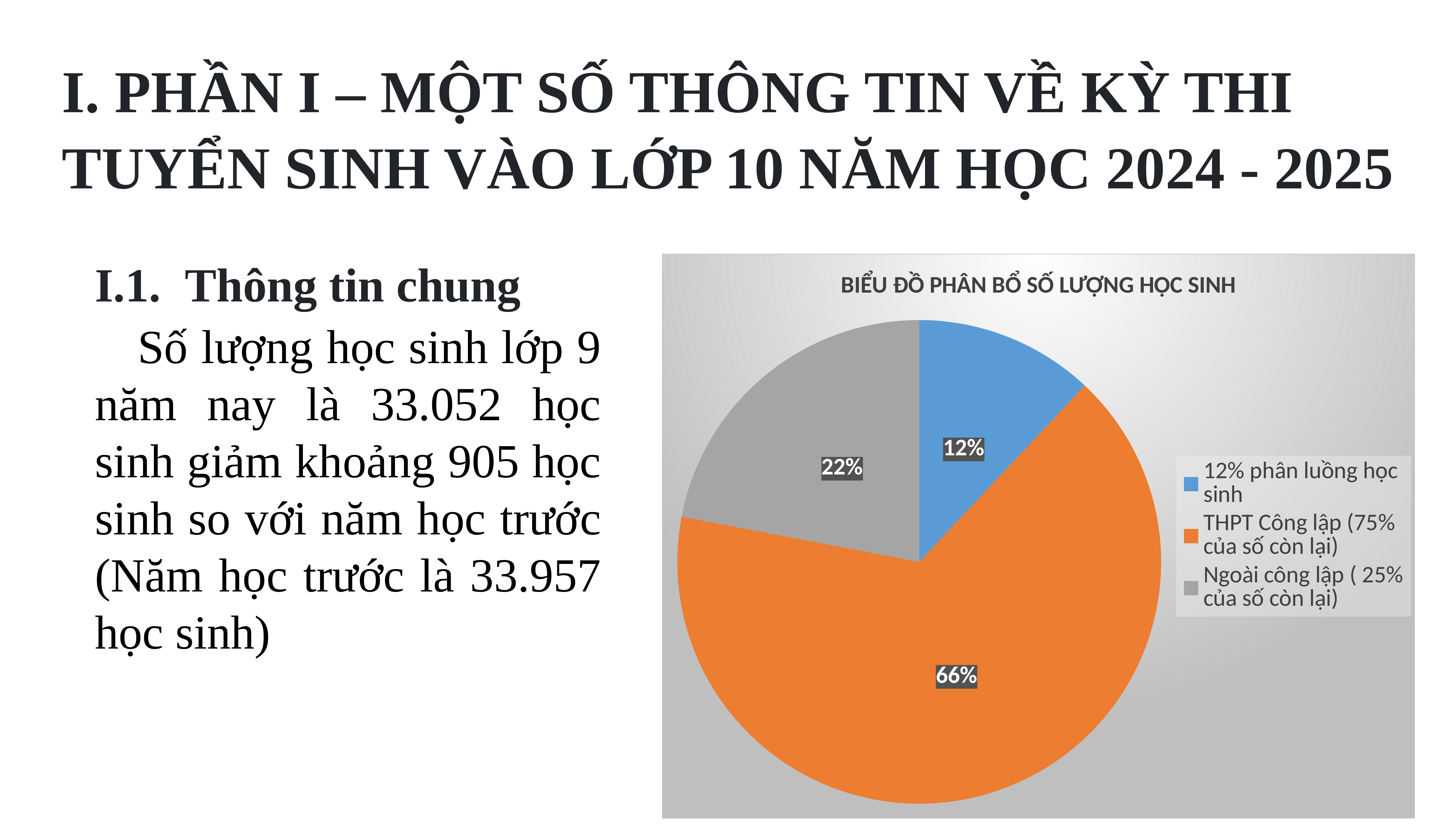
Which is larger: the 'Ngoài công lập' slice or the '12% phân luồng học sinh' slice? Ngoài công lập ( 25% của số còn lại) What is the title of the chart? BIỂU ĐỒ PHÂN BỔ SỐ LƯỢNG HỌC SINH Which slice of the pie is the largest? THPT Công lập (75% của số còn lại) What share of the pie does the '12% phân luồng học sinh' slice represent? 12% How many slices does the pie chart have? 3 What colour is the 'THPT Công lập (75% của số còn lại)' slice? orange What share of the pie does the 'Ngoài công lập ( 25% của số còn lại)' slice represent? 22% What is the difference between the 'THPT Công lập' slice and the 'Ngoài công lập' slice? 44% What share of the pie does the 'THPT Công lập (75% của số còn lại)' slice represent? 66% How many entries does the legend list? 3 Which slice of the pie is the smallest? 12% phân luồng học sinh What kind of chart is shown on the slide? pie chart